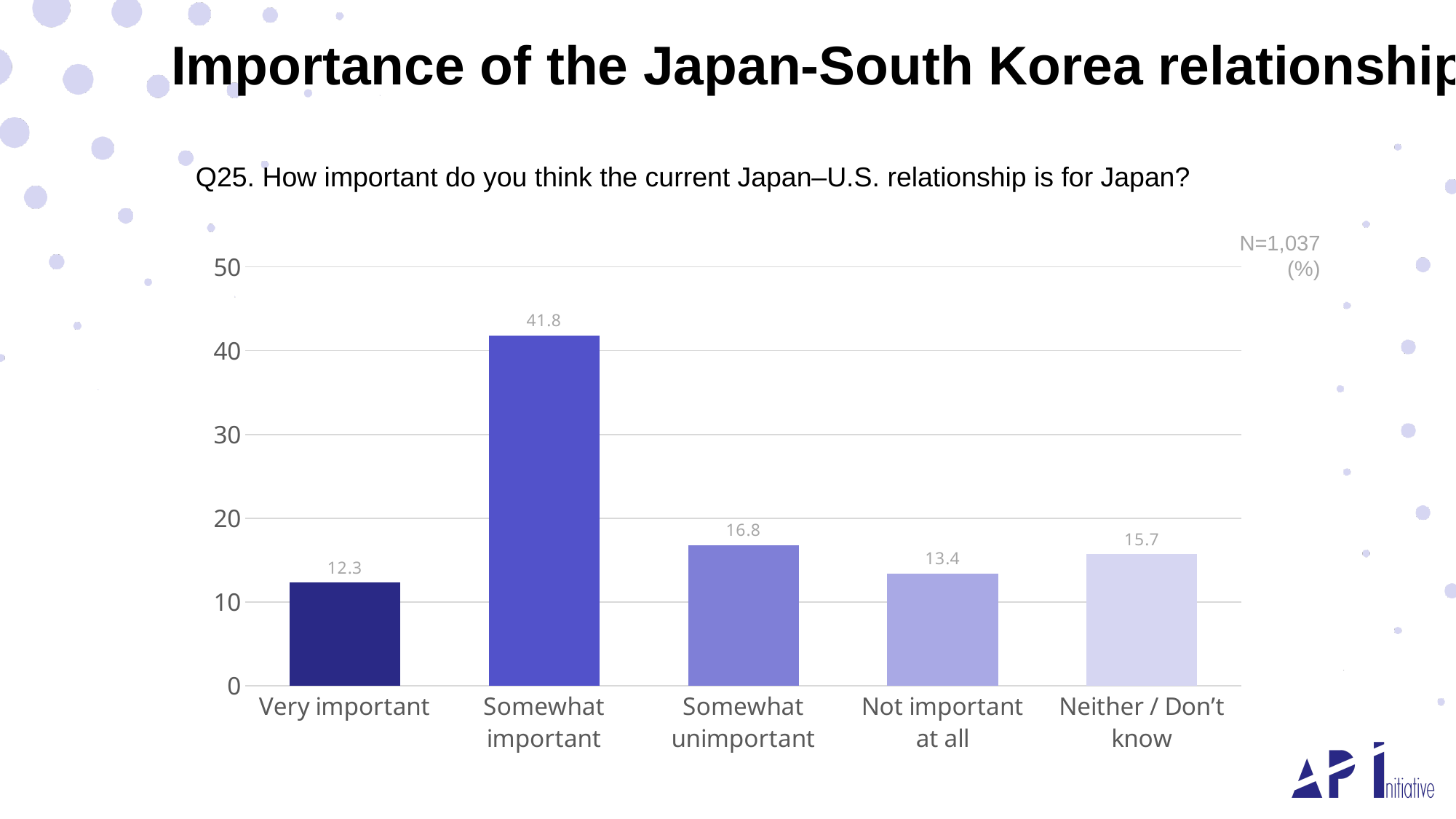
Is the value for "Somewhat important" greater or less than 40? greater Which is larger, the value for "Somewhat unimportant" or the value for "Neither / Don't know"? Somewhat unimportant What is the difference between the values for "Somewhat unimportant" and "Not important at all"? 3.4 What kind of chart is shown on the slide? bar chart What is the value for "Neither / Don't know"? 15.7 What is the value for "Somewhat important"? 41.8 Which category has the lowest value? Very important How many categories are shown on the x axis? 5 What is the difference between the values for "Somewhat important" and "Somewhat unimportant"? 25.0 What is the value for "Very important"? 12.3 What sample size (N) is shown on the chart? N=1,037 Which category has the highest value? Somewhat important